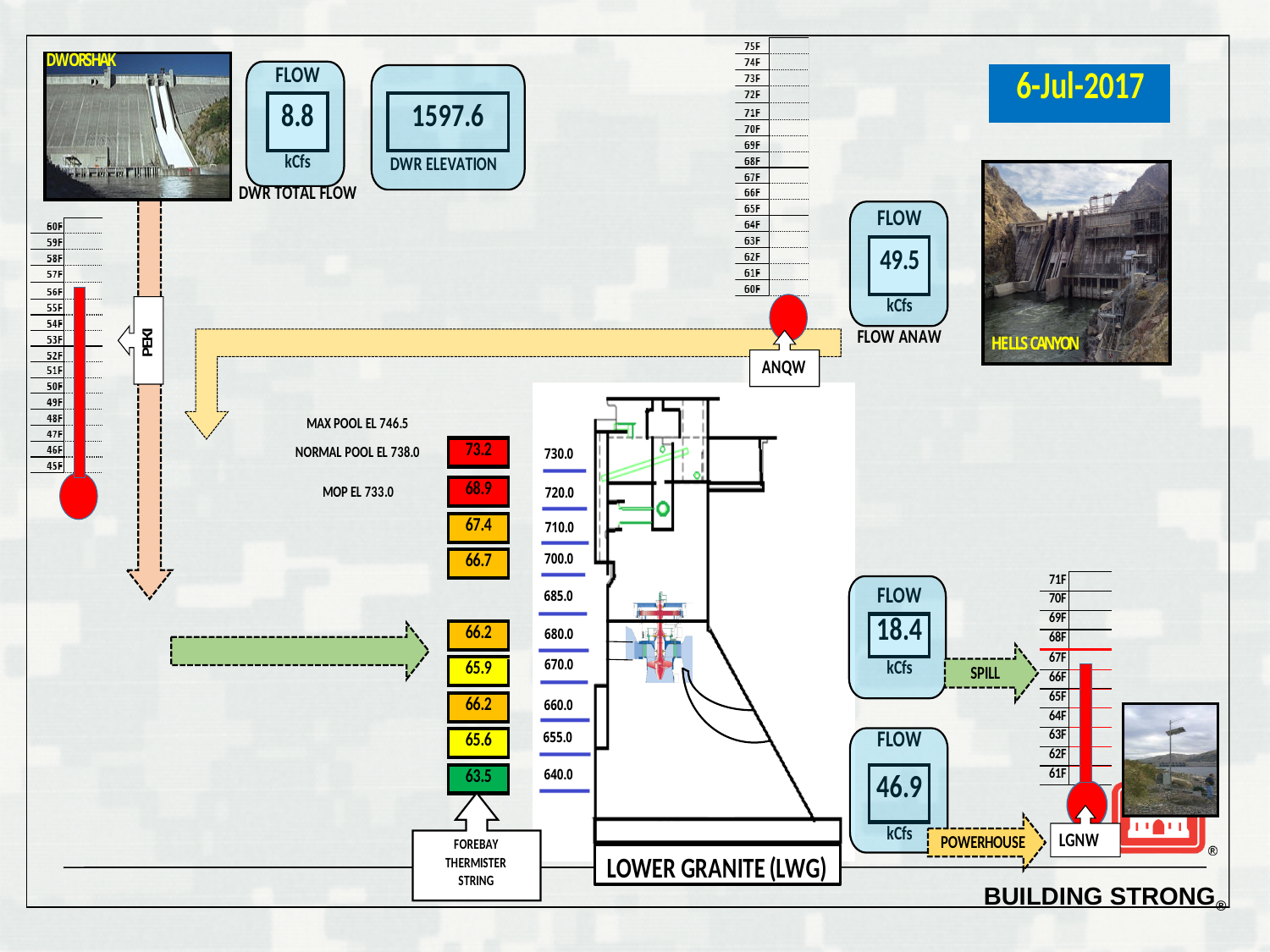
What is the POWERHOUSE flow value shown for Lower Granite? 46.9 kCfs What is the highest temperature value shown in the forebay thermister string? 73.2 On the PEKI thermometer gauge, is the temperature reading greater or less than 50F? greater What is the SPILL flow value shown for Lower Granite? 18.4 kCfs What is the DWR ELEVATION value shown on the slide? 1597.6 How many temperature values are shown in the forebay thermister string? 9 What is the lowest temperature value shown in the forebay thermister string? 63.5 What is the FLOW ANAW value shown near the ANQW gauge? 49.5 kCfs What is the DWR total flow value shown in the FLOW box next to the Dworshak photo? 8.8 kCfs On the LGNW thermometer gauge, is the temperature reading greater or less than 65F? greater What is the difference between the POWERHOUSE flow and the SPILL flow at Lower Granite? 28.5 kCfs Which is larger at Lower Granite, the SPILL flow or the POWERHOUSE flow? POWERHOUSE flow